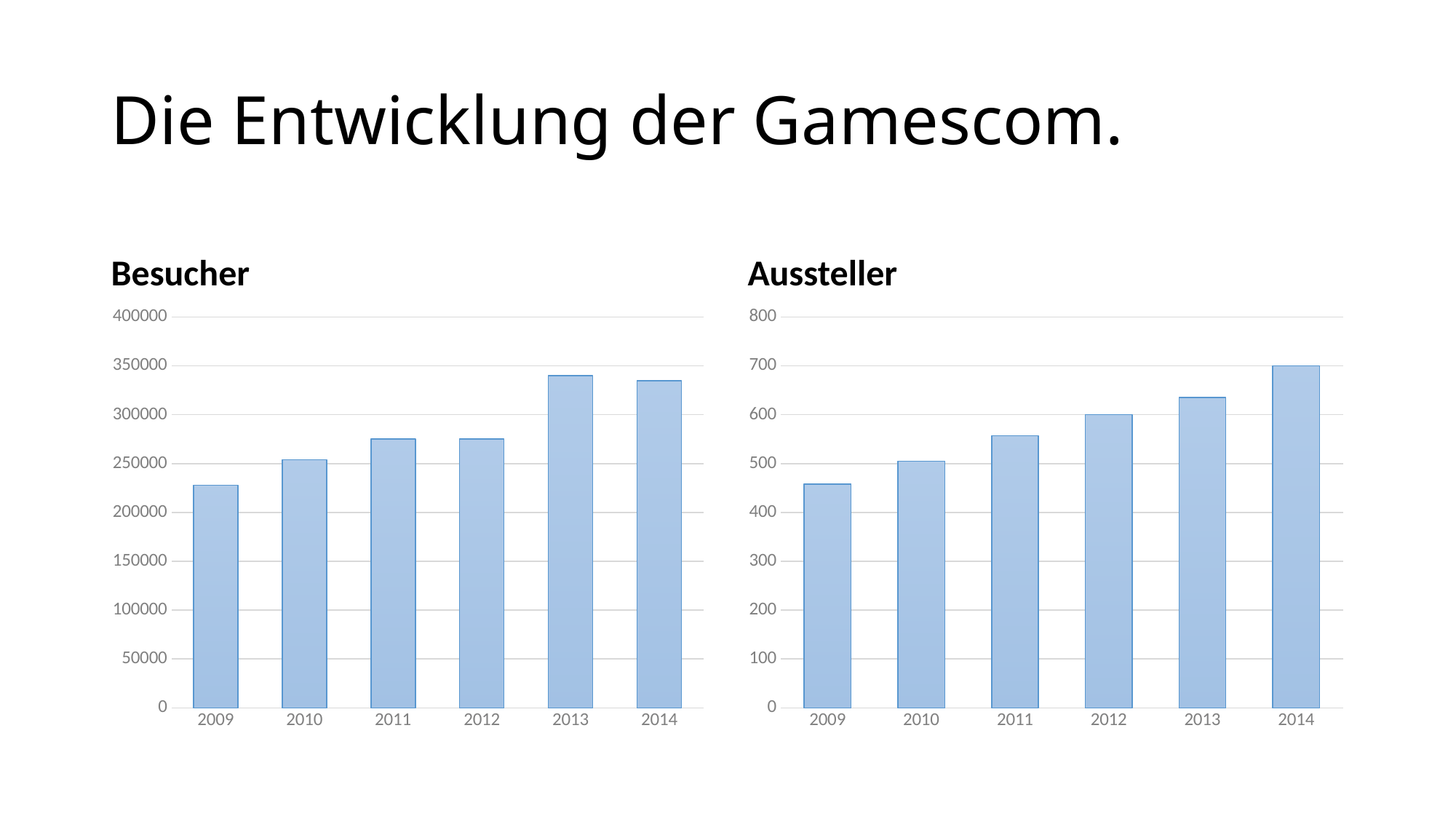
In the Aussteller chart, which is larger, the value for 2010 or the value for 2011? 2011 In the Besucher chart, is the value for 2009 greater or less than 250000? less In the Aussteller chart, what is the value for 2014? 700 In the Aussteller chart, is the value for 2009 greater or less than 500? less In the Besucher chart, which year has the lowest value? 2009 How many years are shown on the Aussteller chart? 6 In the Aussteller chart, do the values rise or fall from 2009 to 2014? rise What type of chart is the Besucher chart? bar chart In the Besucher chart, is the value for 2013 greater or less than 300000? greater In the Aussteller chart, which year has the lowest value? 2009 In the Besucher chart, which year has the highest value? 2013 In the Aussteller chart, which year has the highest value? 2014